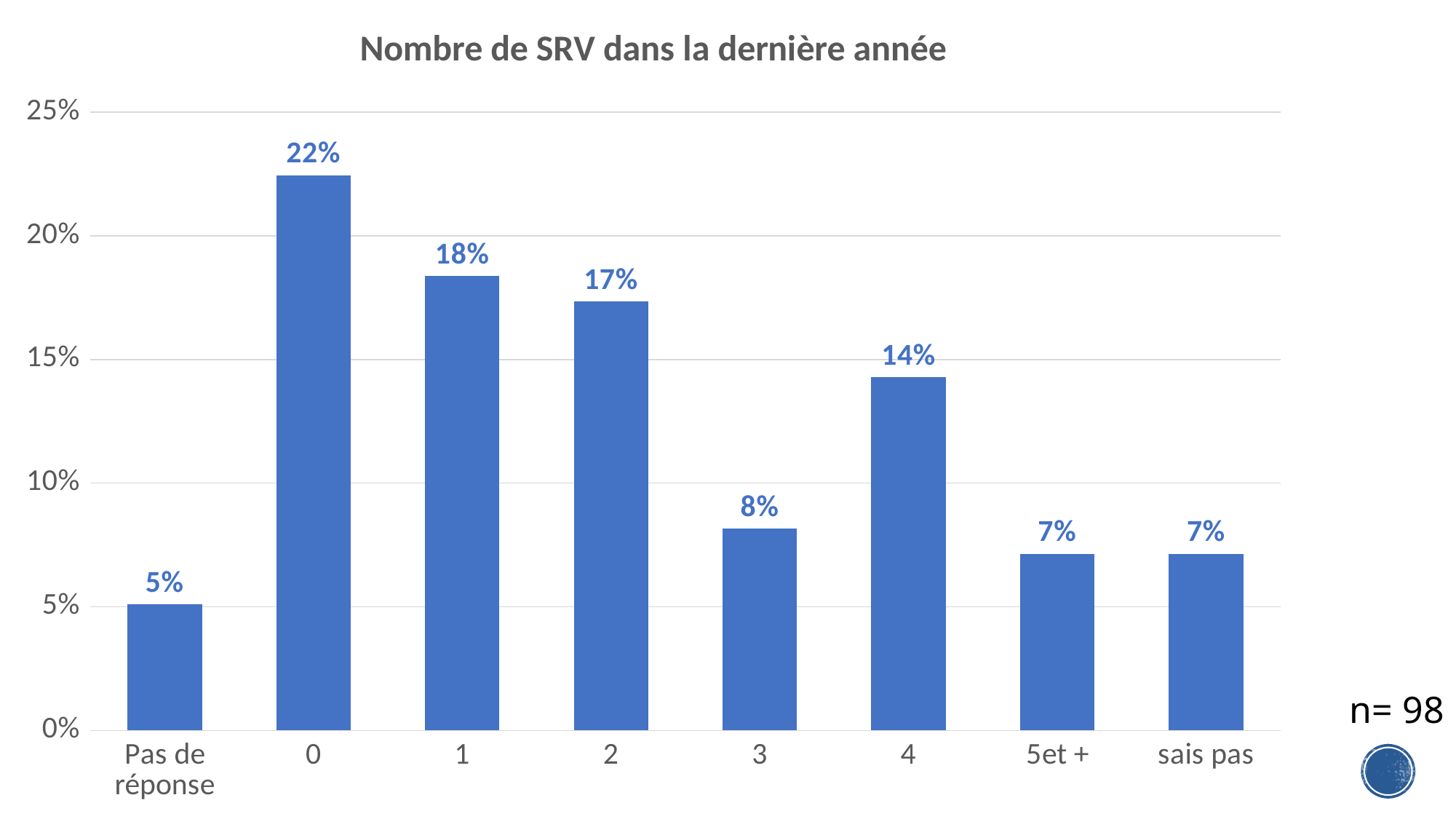
What is the value for "Pas de réponse"? 5% Which is larger, the value for "2" or the value for "4"? 2 What kind of chart is this? bar chart What is the value for "sais pas"? 7% Which category has the highest value? 0 What is the value for the category "0"? 22% How many categories are shown on the x axis? 8 What is the title of the chart? Nombre de SRV dans la dernière année What is the value for the category "4"? 14% What is the difference between the values for "1" and "3"? 10% Is the value for "1" greater or less than 15%? greater Which category has the lowest value? Pas de réponse